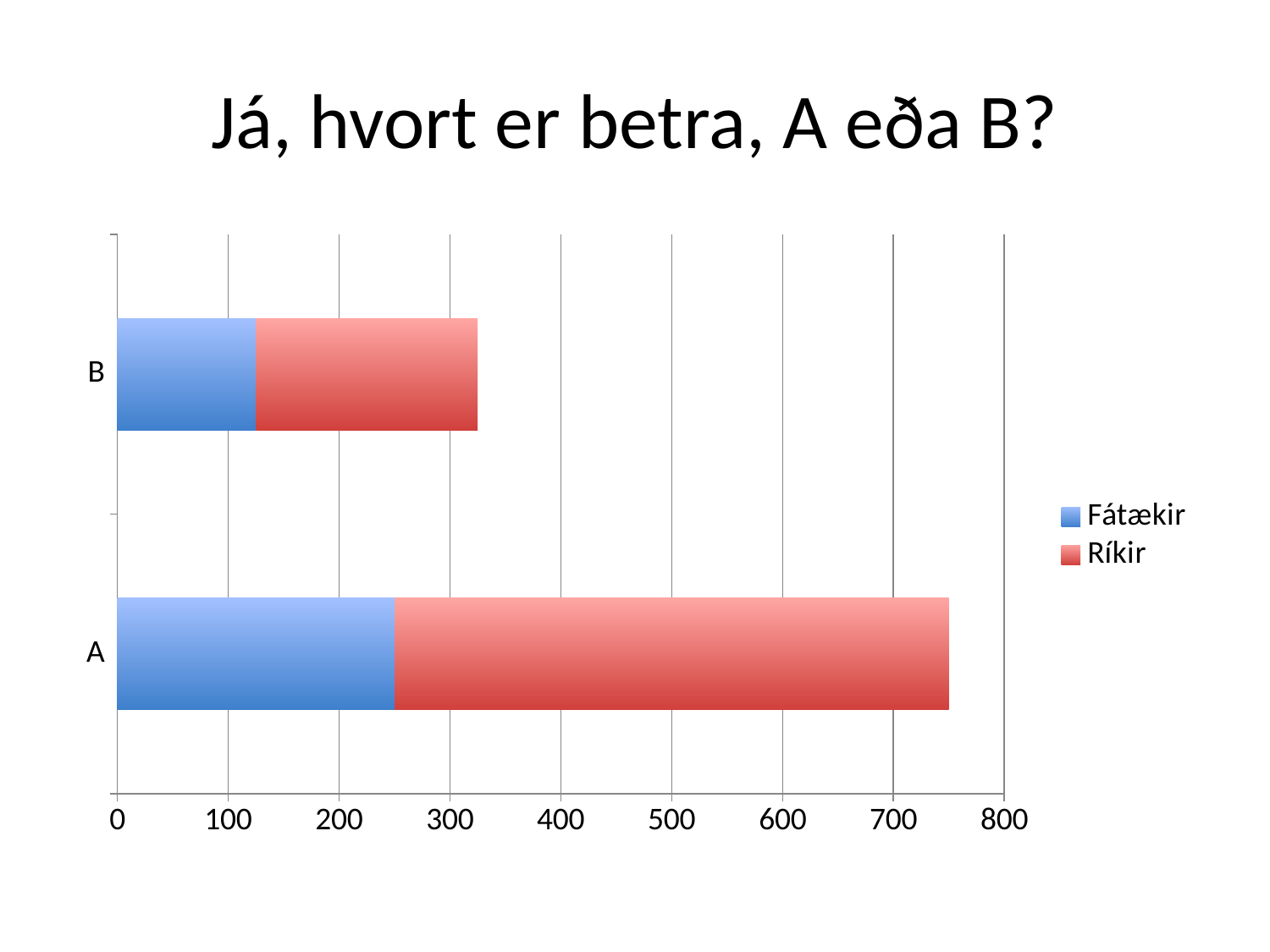
Is the total value for B greater or less than 400? less How many series does the legend list? 2 Is the Fátækir value for B greater or less than 200? less Which category has the shortest total bar? B Which category has the longer total bar, A or B? A Which category has the longest total bar? A Which series is shown in red? Ríkir What kind of chart is shown on the slide? bar chart How many categories are shown on the chart? 2 Is the Fátækir value for A greater or less than 200? greater What is the title of the slide? Já, hvort er betra, A eða B?